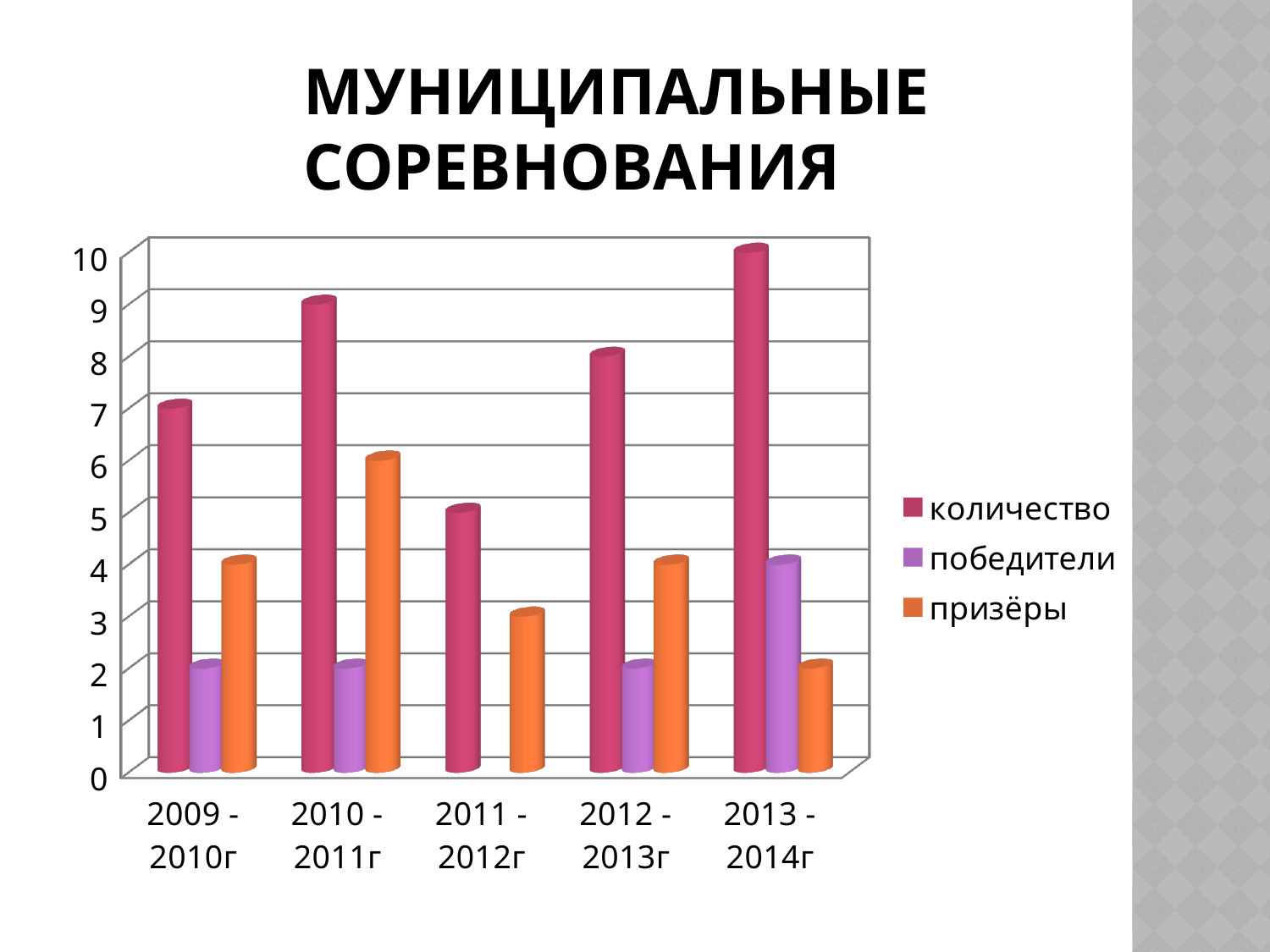
How many periods are shown on the x axis? 5 What is the title of the slide? МУНИЦИПАЛЬНЫЕ СОРЕВНОВАНИЯ Is the value for количество in 2011 - 2012г greater or less than 6? less What are the three series listed in the legend? количество, победители, призёры Is the value for призёры in 2010 - 2011г greater or less than 5? greater Which period has the lowest value for количество? 2011 - 2012г What kind of chart is shown on the slide? bar chart Is the value for количество in 2013 - 2014г greater or less than 8? greater How many series does the legend list? 3 Which period has the highest value for призёры? 2010 - 2011г Which is larger: победители in 2013 - 2014г or победители in 2009 - 2010г? 2013 - 2014г Which period has the highest value for количество? 2013 - 2014г